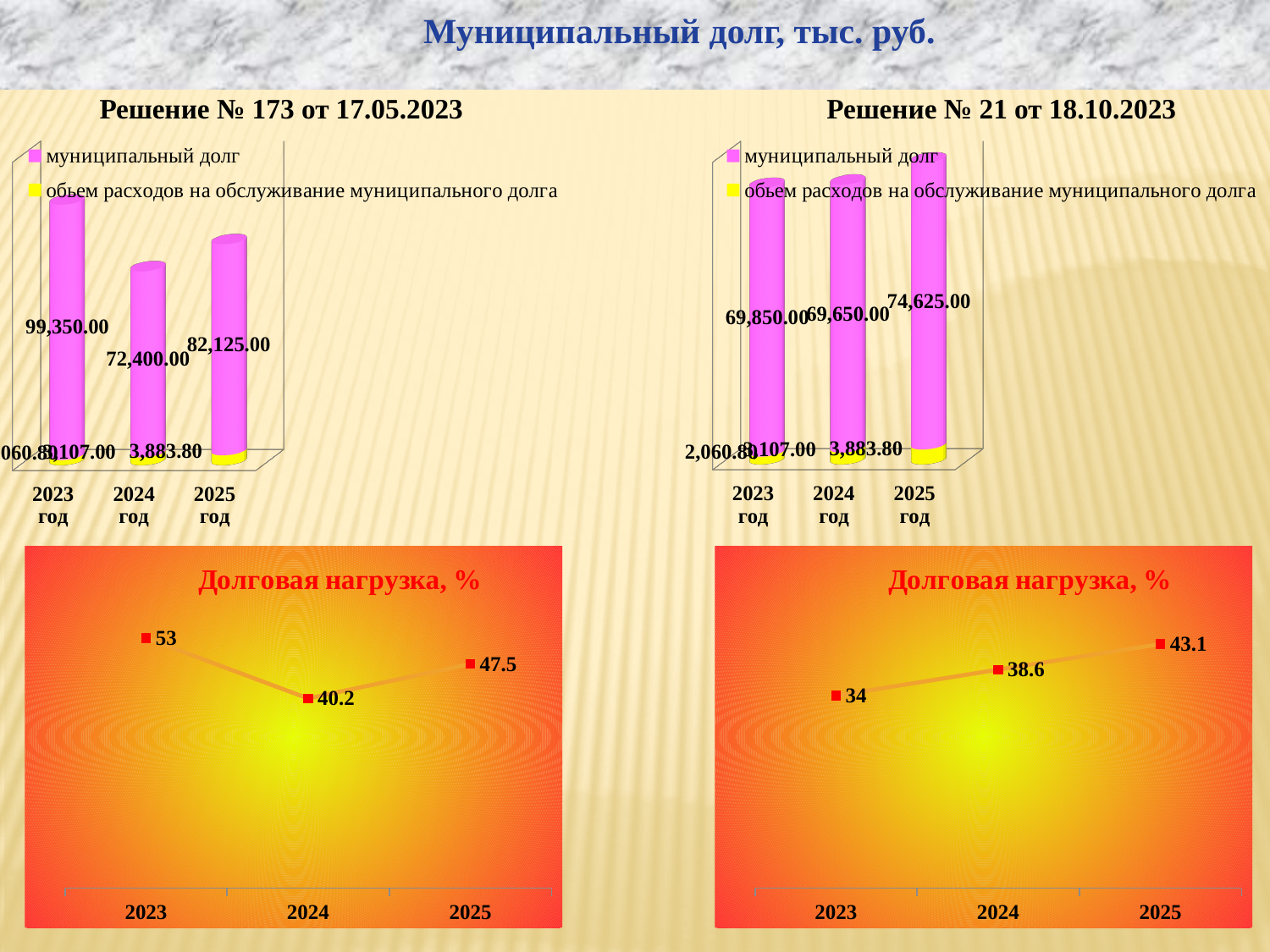
In the top-left bar chart (Решение № 173 от 17.05.2023), what is the difference between муниципальный долг in 2023 год and 2024 год? 26,950.00 In the bottom-right line chart (Долговая нагрузка, %), what is the difference between the values for 2025 and 2023? 9.1 What kind of chart is the bottom-left chart titled Долговая нагрузка, %? line chart How many series does the legend of the top-right bar chart (Решение № 21 от 18.10.2023) list? 2 In the top-right bar chart (Решение № 21 от 18.10.2023), what is the value of обьем расходов на обслуживание муниципального долга for 2025 год? 3,883.80 In the top-right bar chart (Решение № 21 от 18.10.2023), which year has the highest муниципальный долг? 2025 год In the bottom-right line chart (Долговая нагрузка, %), do the values rise or fall from 2023 to 2025? rise In the top-left bar chart (Решение № 173 от 17.05.2023), what is the value of муниципальный долг for 2023 год? 99,350.00 In the top-right bar chart (Решение № 21 от 18.10.2023), what is the value of муниципальный долг for 2025 год? 74,625.00 In the bottom-left line chart (Долговая нагрузка, %), what is the value for 2024? 40.2 In the top-left bar chart (Решение № 173 от 17.05.2023), which year has the highest муниципальный долг? 2023 год In the top-left bar chart (Решение № 173 от 17.05.2023), what is the value of муниципальный долг for 2024 год? 72,400.00